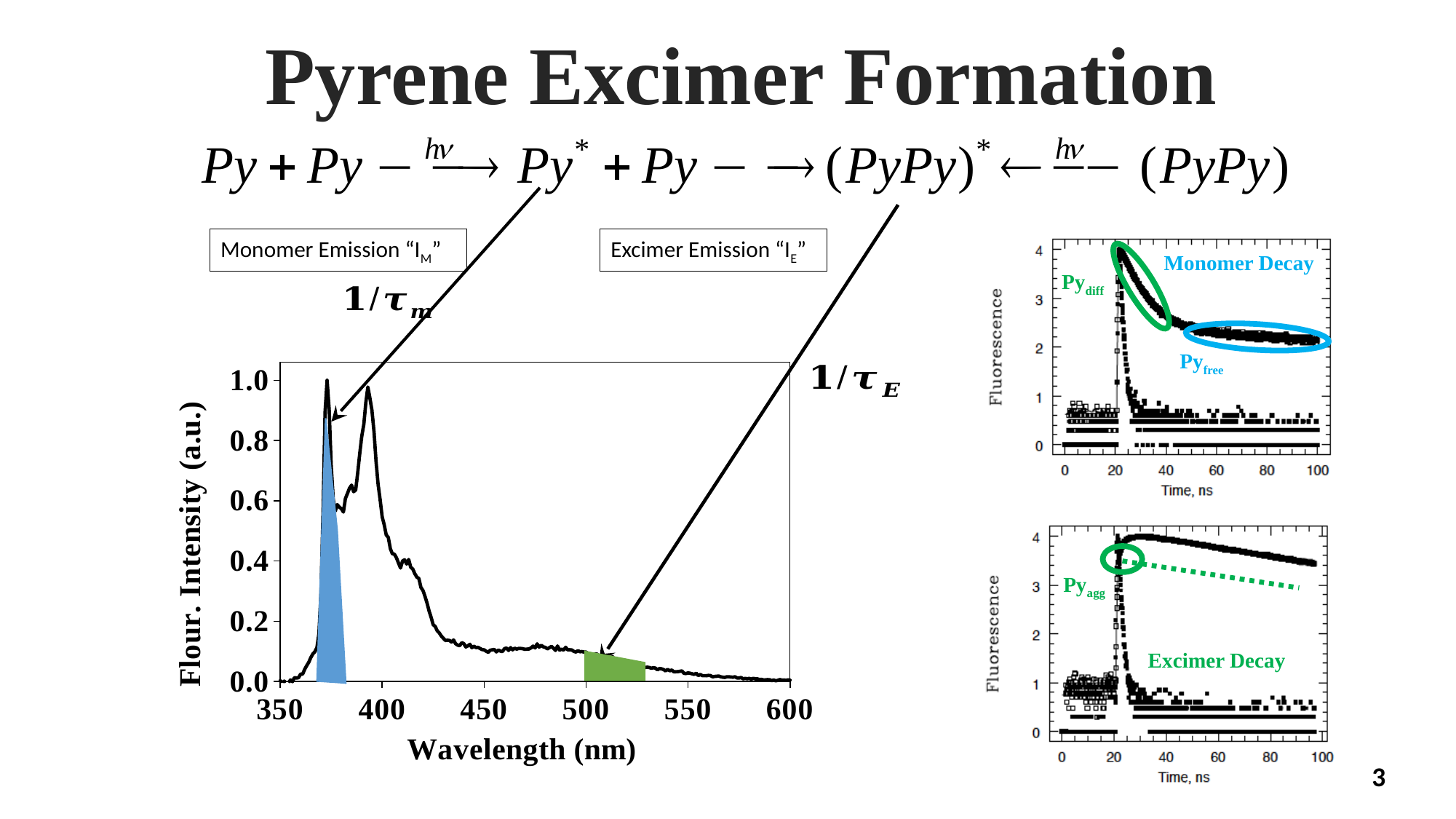
In the left chart, what is the label of the x axis? Wavelength (nm) In the top right chart (Monomer Decay), is the fluorescence at 80 ns greater or less than 3? less In the left chart, is the intensity at 500 nm greater or less than 0.2? less In the left chart, is the intensity at 375 nm larger or smaller than the intensity at 550 nm? larger How many charts are shown on the slide? 3 In the bottom right chart (Excimer Decay), is the fluorescence of the solid data at 80 ns greater or less than 3? greater In the top right chart (Monomer Decay), does the fluorescence rise or fall between 20 ns and 40 ns? fall In the left chart, which shaded region lies at the shorter wavelength, the blue one or the green one? the blue one In the left chart, what is the label of the y axis? Flour. Intensity (a.u.) What kind of chart is the large chart on the left of the slide? line chart In the left chart, does the intensity rise or fall overall between 450 nm and 600 nm? fall